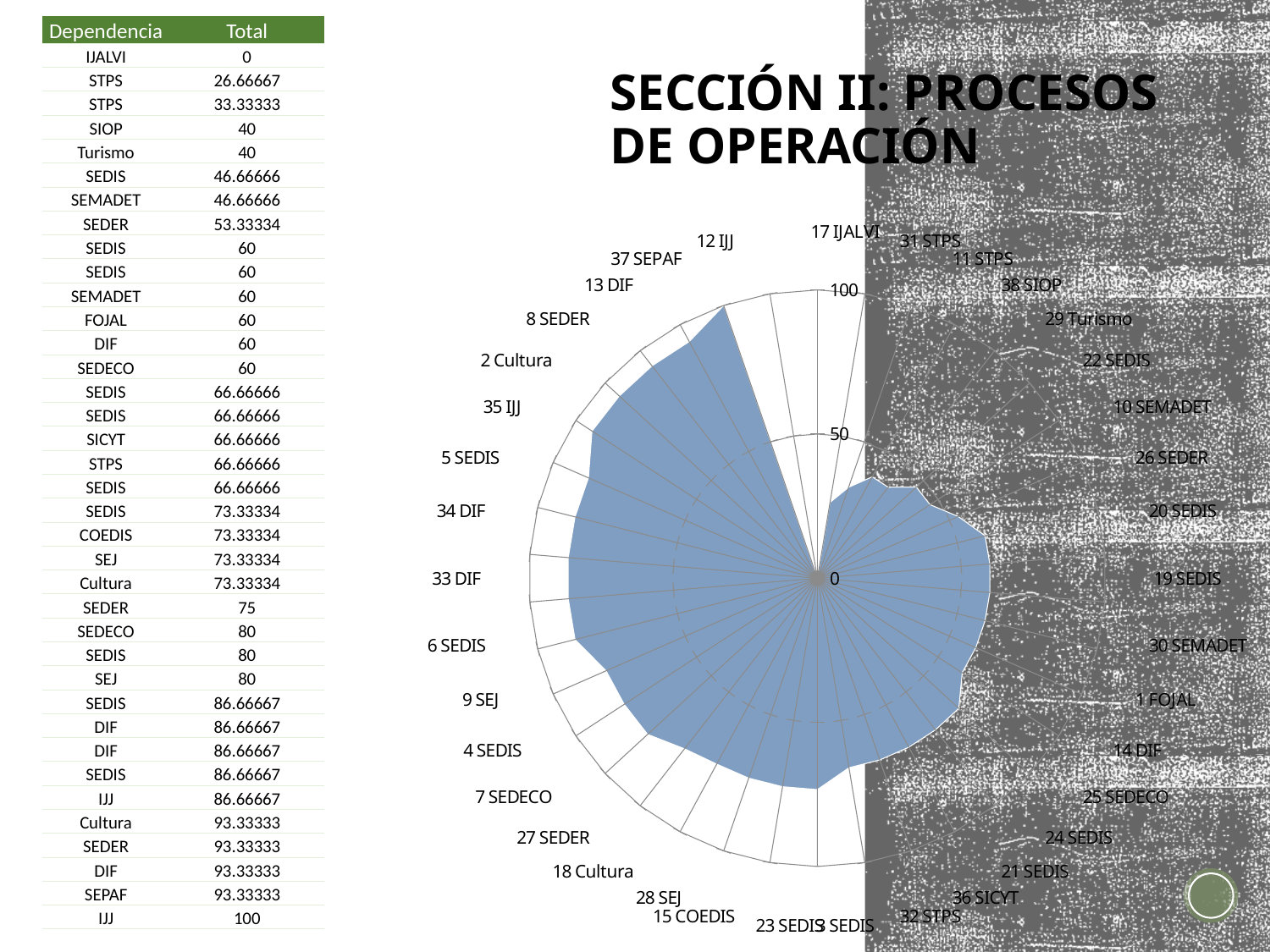
Is the value for 12 IJJ greater or less than 50? greater Which has the larger value, 17 IJALVI or 1 FOJAL? 1 FOJAL Is the value for 17 IJALVI greater or less than 50? less Which category on the radar chart has the highest value? 12 IJJ What kind of chart is shown on the slide? Radar chart What is the maximum value shown on the radar chart's axis? 100 Which category on the radar chart has the lowest value? 17 IJALVI Which has the larger value, 12 IJJ or 31 STPS? 12 IJJ Is the value for 33 DIF greater or less than 50? greater What is the title of the slide containing the radar chart? SECCIÓN II: PROCESOS DE OPERACIÓN